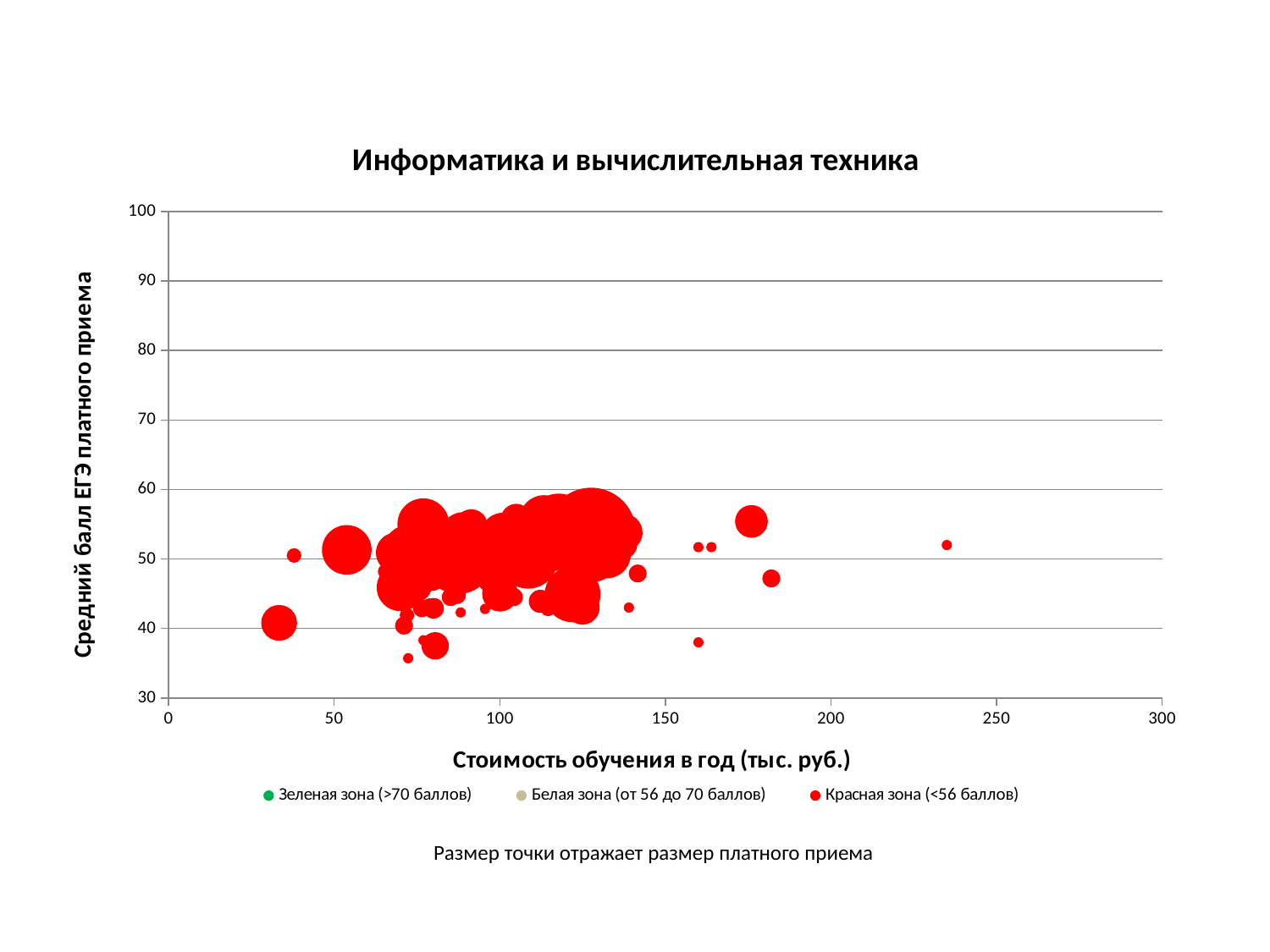
Is the tuition cost (x value) of the leftmost bubble greater or less than 50? less Which legend series do all the plotted bubbles belong to? Красная зона (<56 баллов) How many series does the legend list? 3 Is the average score (y value) of the largest bubble greater or less than 40? greater Is the average score (y value) of the highest bubble greater or less than 70? less What is the title of the chart? Информатика и вычислительная техника What kind of chart is shown on the slide? bubble chart